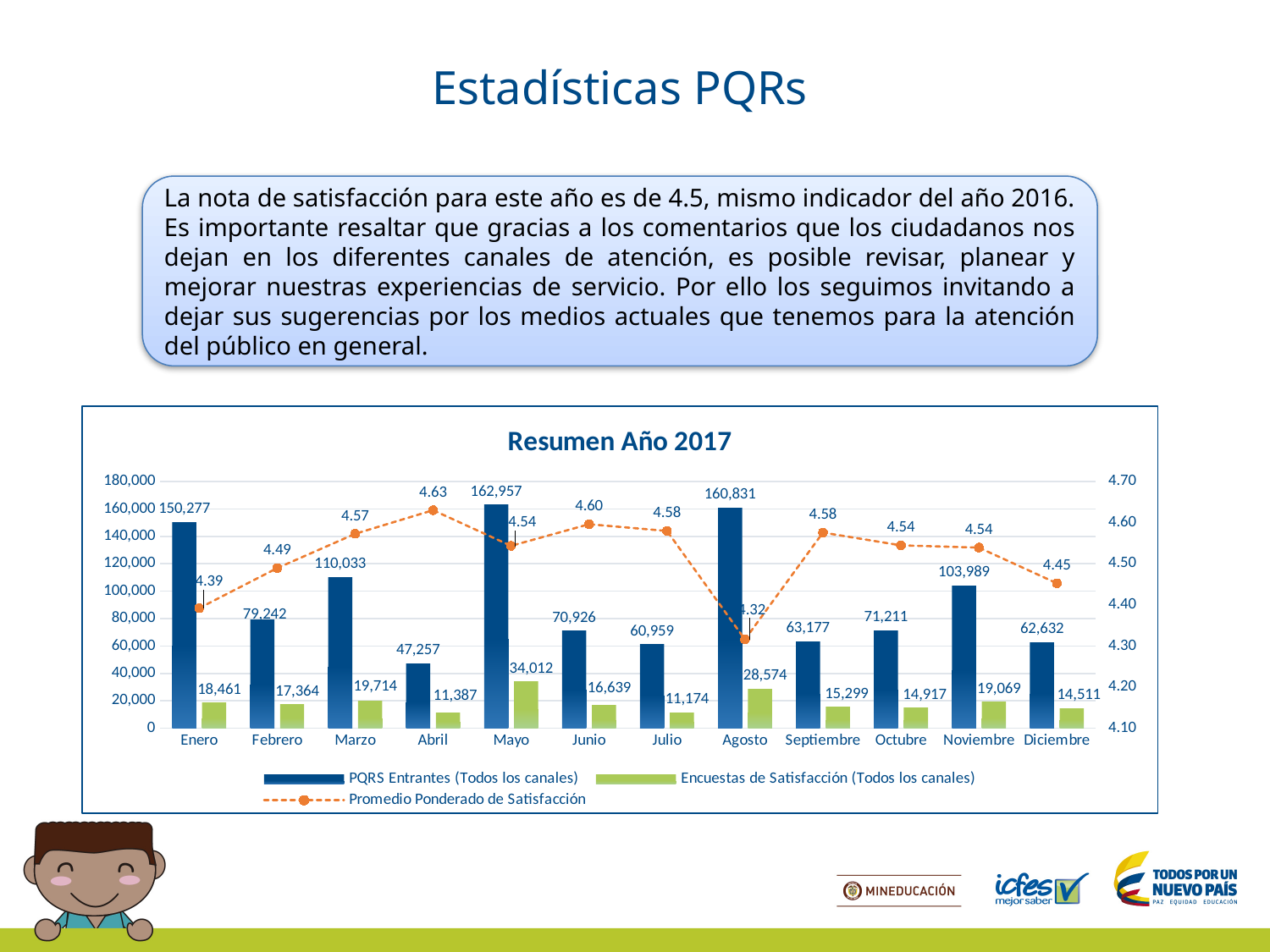
What kind of chart is shown on the slide? Combination bar and line chart What is the value of PQRS Entrantes (Todos los canales) for Mayo? 162,957 How many months are shown on the x axis of the chart? 12 Which month has the highest value of Encuestas de Satisfacción (Todos los canales)? Mayo Which month has the lowest value of PQRS Entrantes (Todos los canales)? Abril What is the title of the chart? Resumen Año 2017 Which is larger, the Encuestas de Satisfacción value for Marzo or for Noviembre? Marzo What is the value of Encuestas de Satisfacción (Todos los canales) for Agosto? 28,574 What is the difference between the PQRS Entrantes values for Mayo and Agosto? 2,126 Which month has the lowest Promedio Ponderado de Satisfacción? Agosto What is the Promedio Ponderado de Satisfacción for Abril? 4.63 How many series does the chart legend list? 3